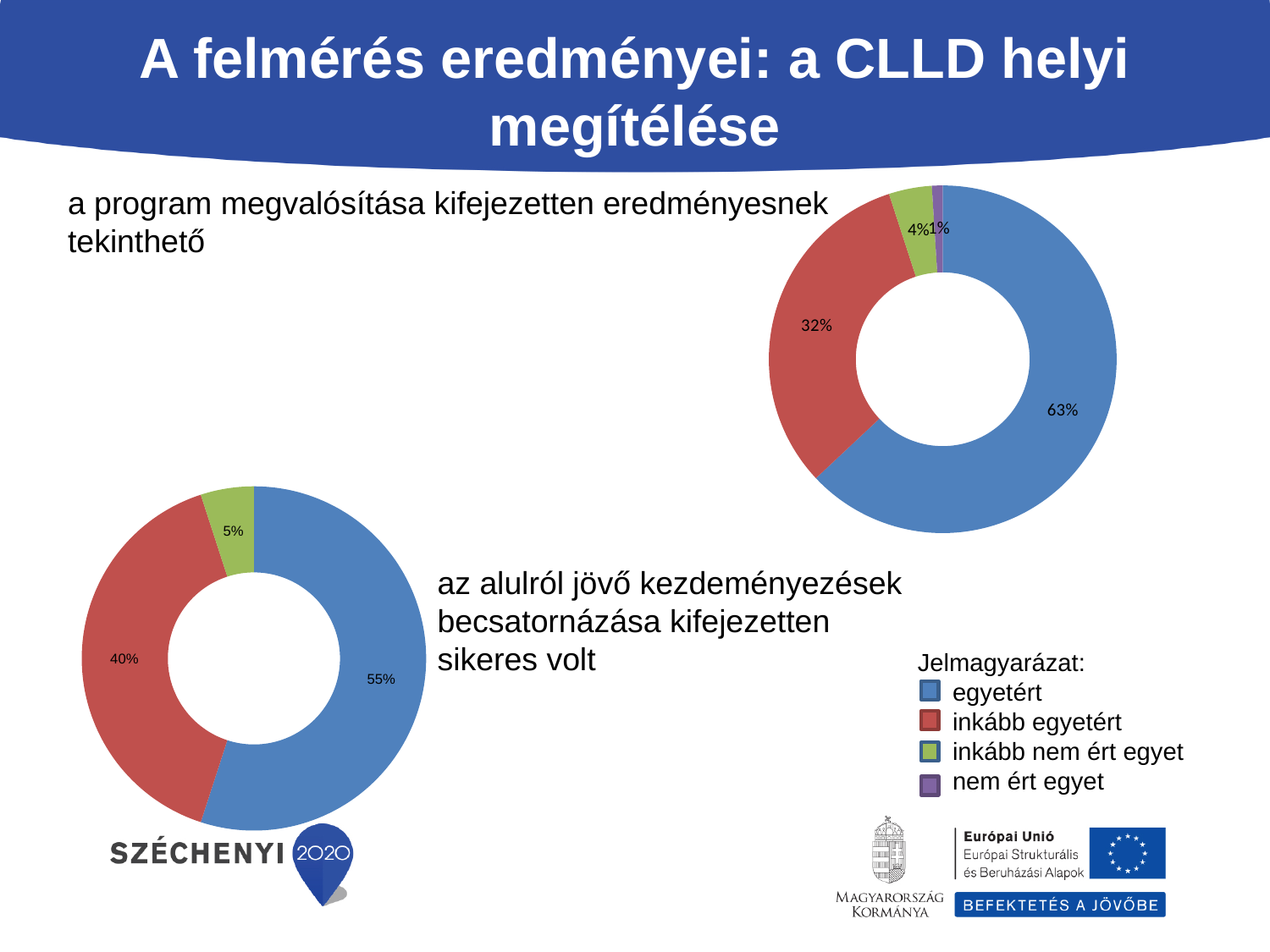
How many entries does the legend (Jelmagyarázat) list? 4 In the top-right chart, what share is shown for "inkább egyetért"? 32% In the bottom-left chart, what share is shown for "inkább nem ért egyet"? 5% How many slices does the bottom-left chart have? 3 In the top-right chart, what is the difference between the shares for "egyetért" and "inkább egyetért"? 31 percentage points What kind of chart is the top-right chart? Doughnut (pie) chart In the top-right chart ("a program megvalósítása kifejezetten eredményesnek tekinthető"), what share is shown for "egyetért"? 63% In the bottom-left chart ("az alulról jövő kezdeményezések becsatornázása kifejezetten sikeres volt"), what share is shown for "egyetért"? 55% In the bottom-left chart, which is larger: the share for "egyetért" or the share for "inkább egyetért"? egyetért In the top-right chart, which category has the smallest share? nem ért egyet In the top-right chart, what share is shown for "nem ért egyet"? 1% In the bottom-left chart, which category has the largest share? egyetért